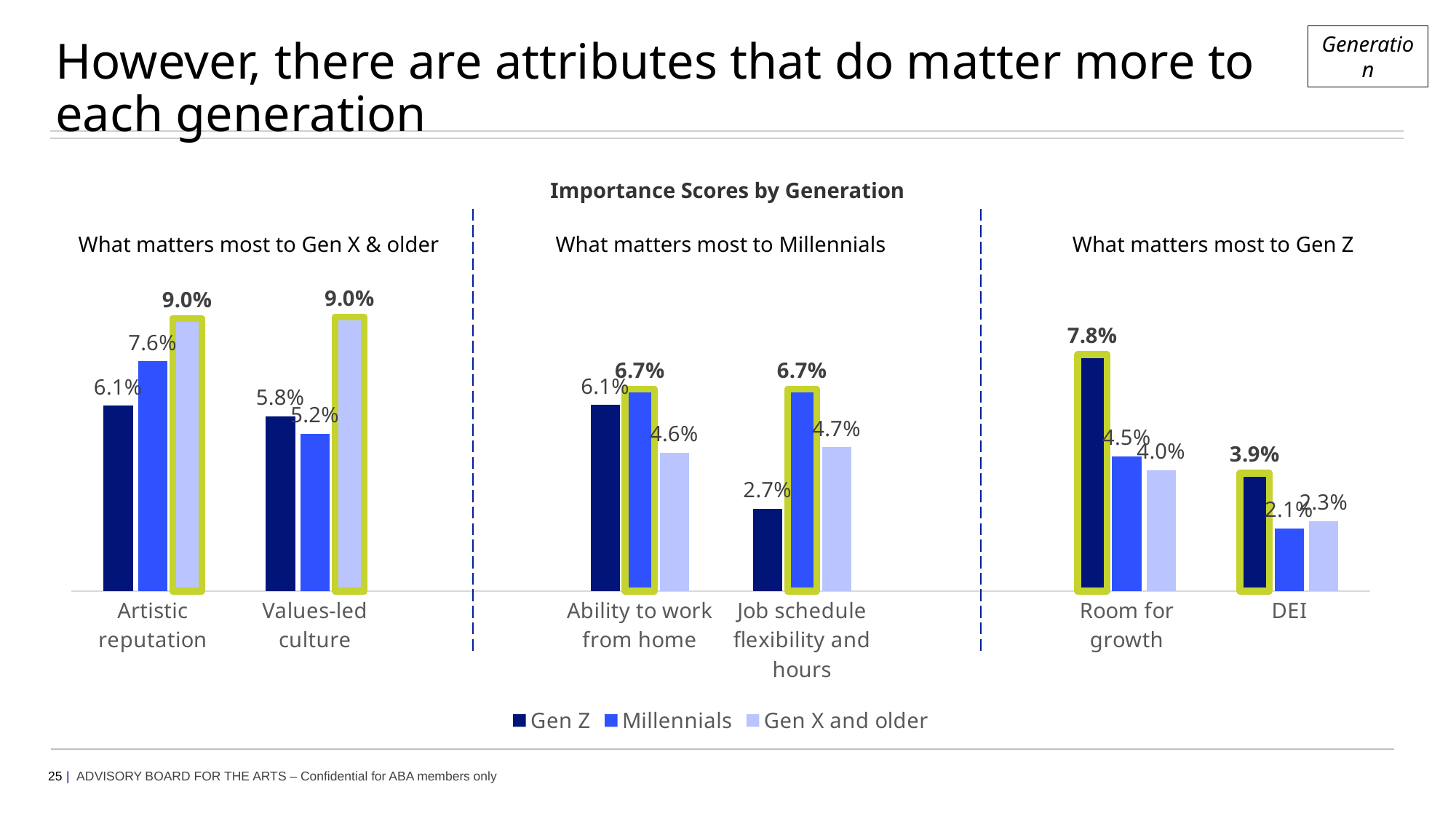
For Ability to work from home, which is larger: the Millennials value or the Gen X and older value? Millennials What is the Gen Z value for Room for growth? 7.8% What is the Gen X and older value for Job schedule flexibility and hours? 4.7% What is the difference between the Gen X and older value and the Gen Z value for Artistic reputation? 2.9 percentage points Which series has the highest value for Values-led culture? Gen X and older What is the Gen Z value for Job schedule flexibility and hours? 2.7% What is the Millennials value for Artistic reputation? 7.6% How many series does the legend list? 3 What is the difference between the Gen Z value and the Millennials value for Room for growth? 3.3 percentage points How many categories are shown on the x axis of the chart? 6 What type of chart is shown on the slide? Bar chart Which series has the lowest value for DEI? Millennials